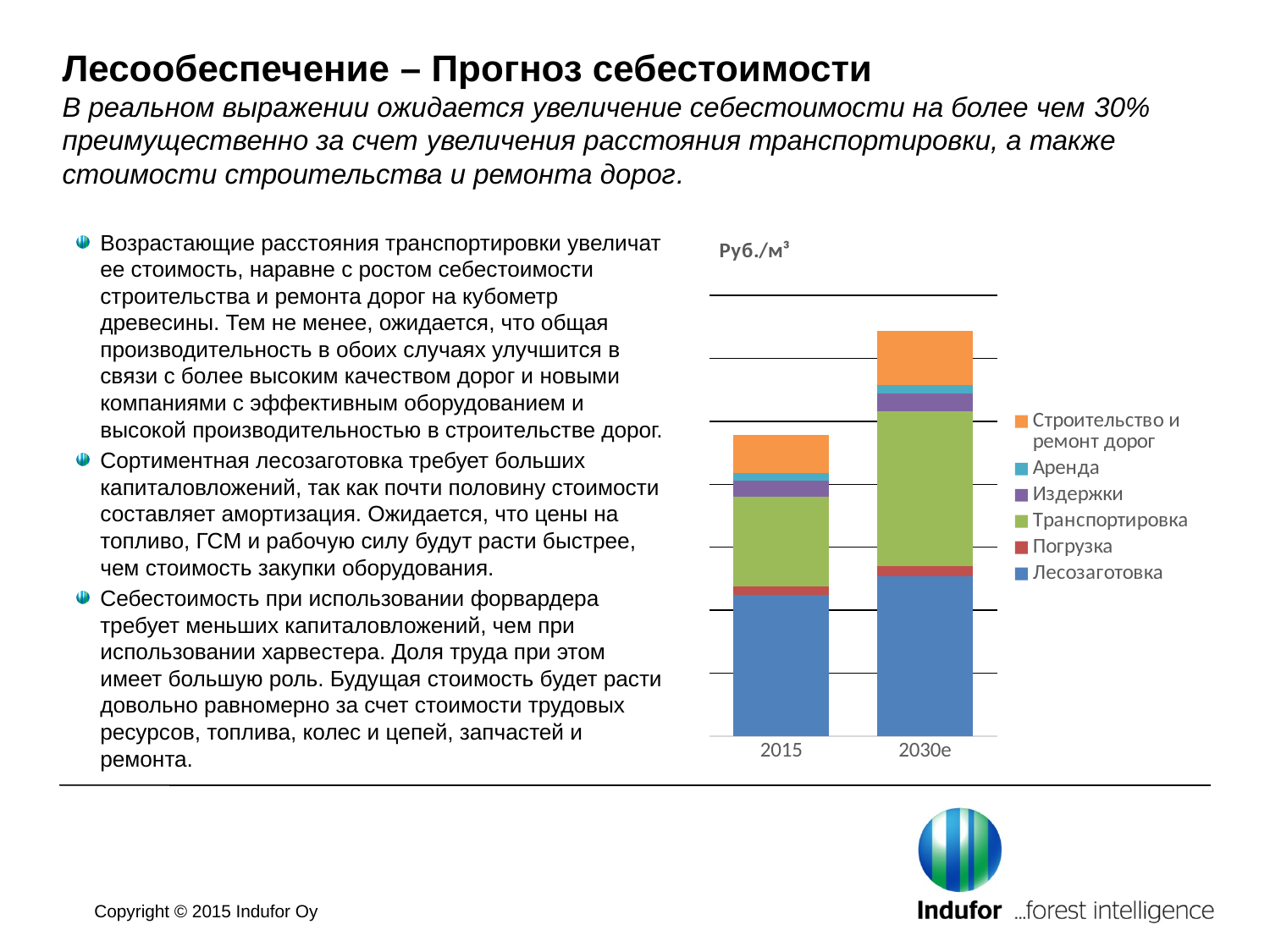
Which series forms the largest segment of the 2015 bar? Лесозаготовка How many categories are shown on the x axis of the chart? 2 What unit label is shown above the chart? Руб./м³ What kind of chart is shown on the slide? Stacked bar chart Is the Транспортировка segment larger in 2015 or in 2030e? 2030e Which series is shown at the bottom of each stacked bar? Лесозаготовка Is the Строительство и ремонт дорог segment larger in 2015 or in 2030e? 2030e How many series does the chart's legend list? 6 Which bar is taller in total, 2015 or 2030e? 2030e Does the total cost per cubic metre rise or fall from 2015 to 2030e? Rises